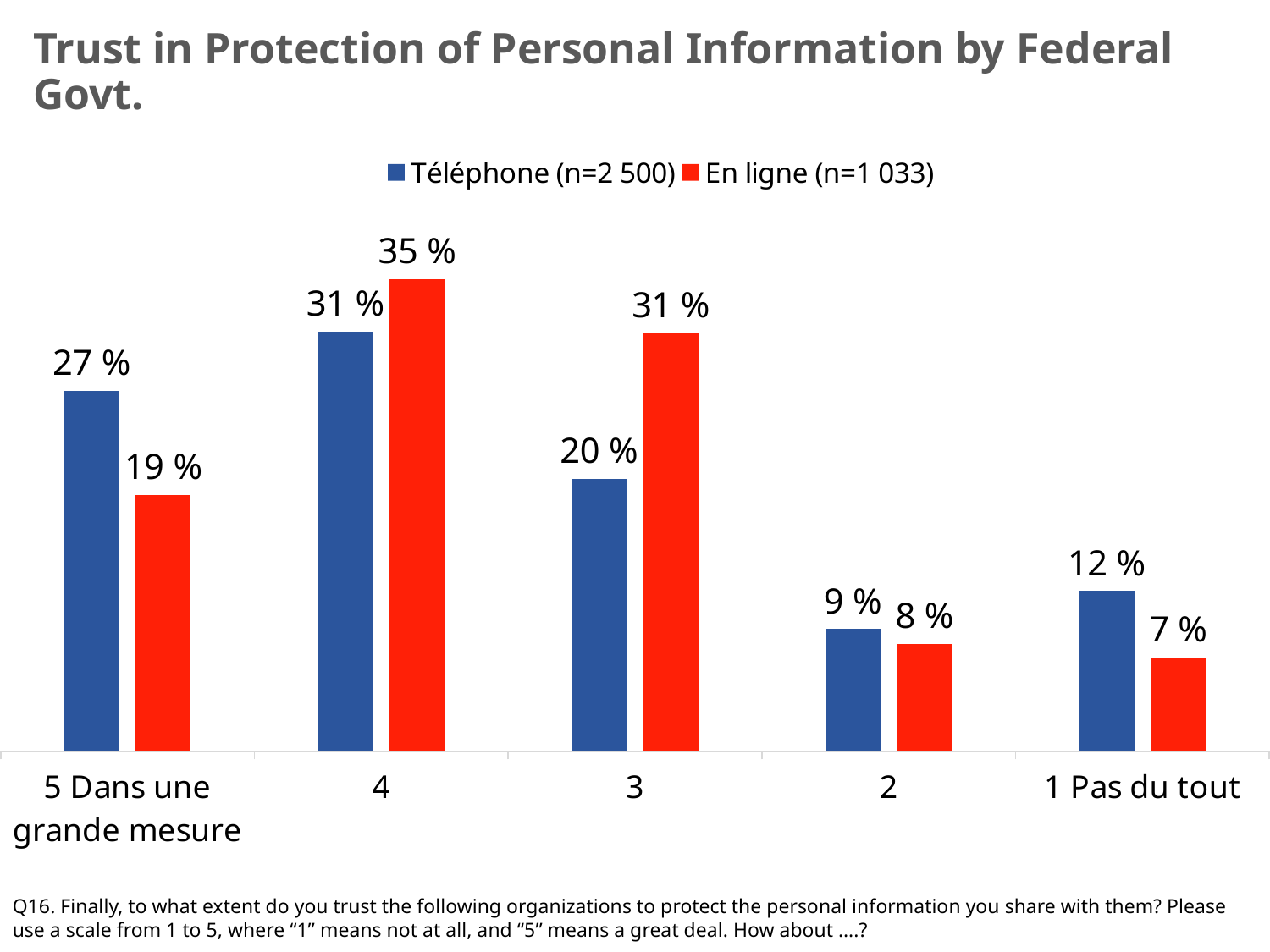
What is the Téléphone value for category '1 Pas du tout'? 12 % For category '5 Dans une grande mesure', which series has the larger value, Téléphone or En ligne? Téléphone How many categories are shown on the x axis? 5 Which category has the highest En ligne value? 4 What is the En ligne value for category '5 Dans une grande mesure'? 19 % What is the difference between the En ligne and Téléphone values for category 3? 11 % Which category has the lowest Téléphone value? 2 What is the En ligne value for category 3? 31 % How many series does the legend list? 2 What is the sample size (n) shown in the legend for the En ligne series? 1 033 What is the Téléphone value for category 4? 31 % What kind of chart is shown on the slide? Bar chart